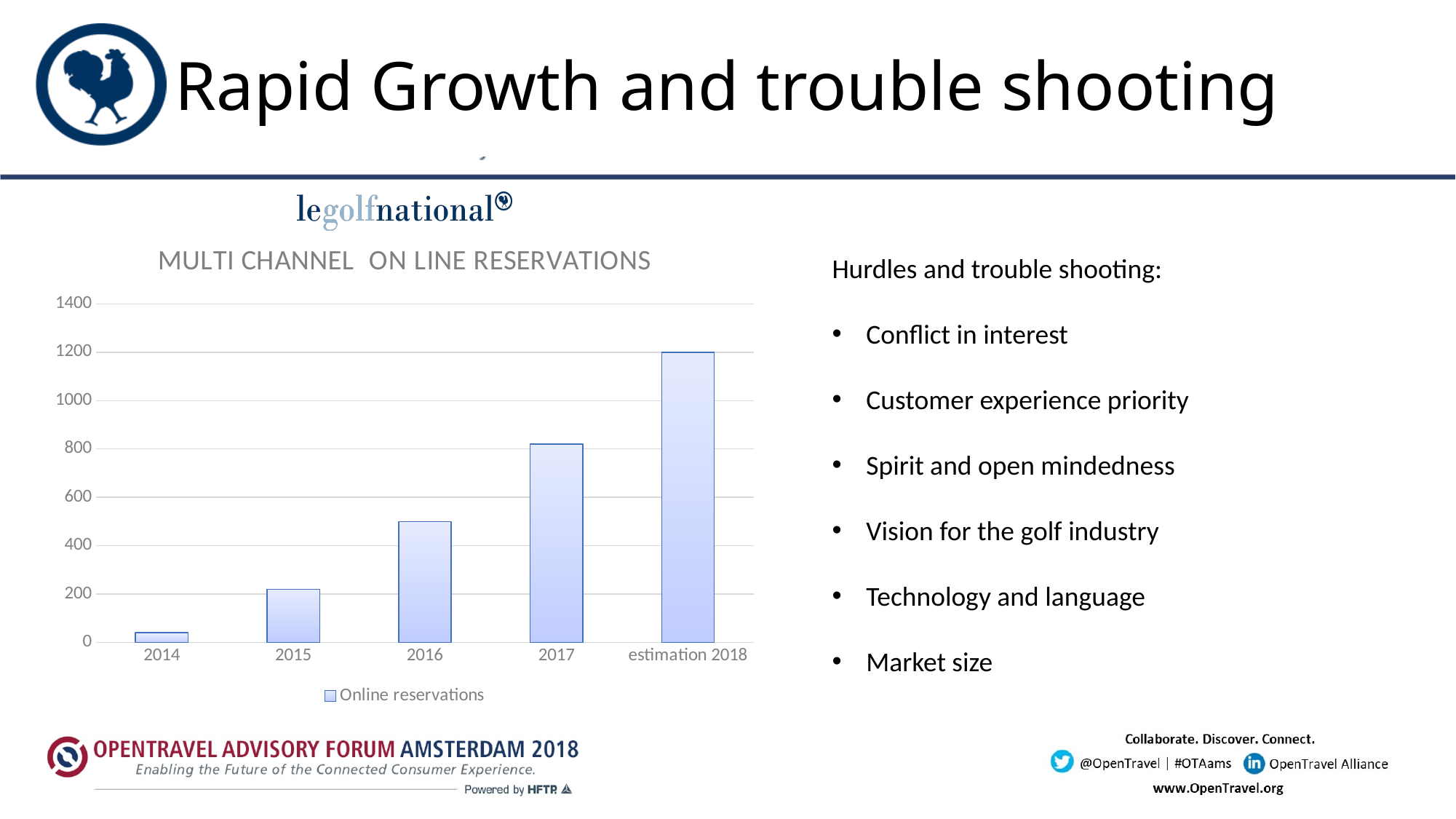
Which category has the lowest value in the chart? 2014 What kind of chart is shown on the slide? bar chart Which category has the highest value in the chart? estimation 2018 What is the name of the series shown in the chart legend? Online reservations How many series does the chart legend list? 1 What is the title of the chart? MULTI CHANNEL ON LINE RESERVATIONS How many categories are shown on the x axis of the chart? 5 Which is larger, the value for 2016 or the value for 2017? 2017 Is the value for 2017 greater or less than 1000? less Is the value for 2014 greater or less than 200? less Do the values rise or fall from 2014 to estimation 2018? rise Is the value for 2016 greater or less than 400? greater